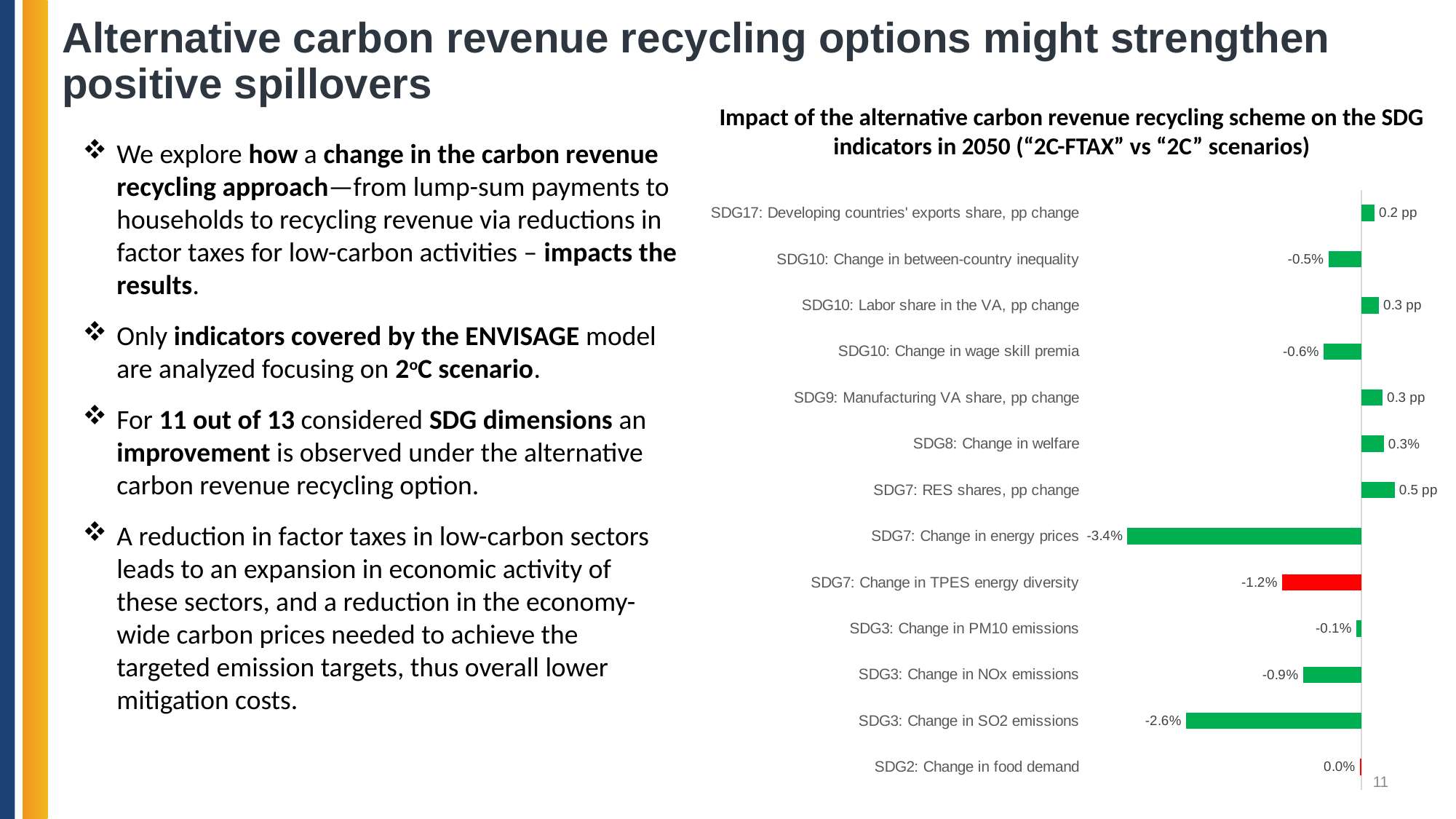
What is the value shown for "SDG7: RES shares, pp change"? 0.5 pp What is the difference between the value for "SDG3: Change in NOx emissions" and "SDG3: Change in PM10 emissions"? 0.8 percentage points What is the value shown for "SDG3: Change in SO2 emissions"? -2.6% What type of chart is shown on the slide? Bar chart What is the value shown for "SDG10: Change in wage skill premia"? -0.6% Which indicator has the lowest (most negative) value in the chart? SDG7: Change in energy prices What is the value shown for "SDG2: Change in food demand"? 0.0% Which indicator is shown with a red bar in the chart? SDG7: Change in TPES energy diversity How many SDG indicators (categories) are plotted in the chart? 13 Which is larger in magnitude: the change in SO2 emissions or the change in NOx emissions? Change in SO2 emissions What is the value shown for "SDG7: Change in energy prices"? -3.4% Which indicator has the highest positive value in the chart? SDG7: RES shares, pp change